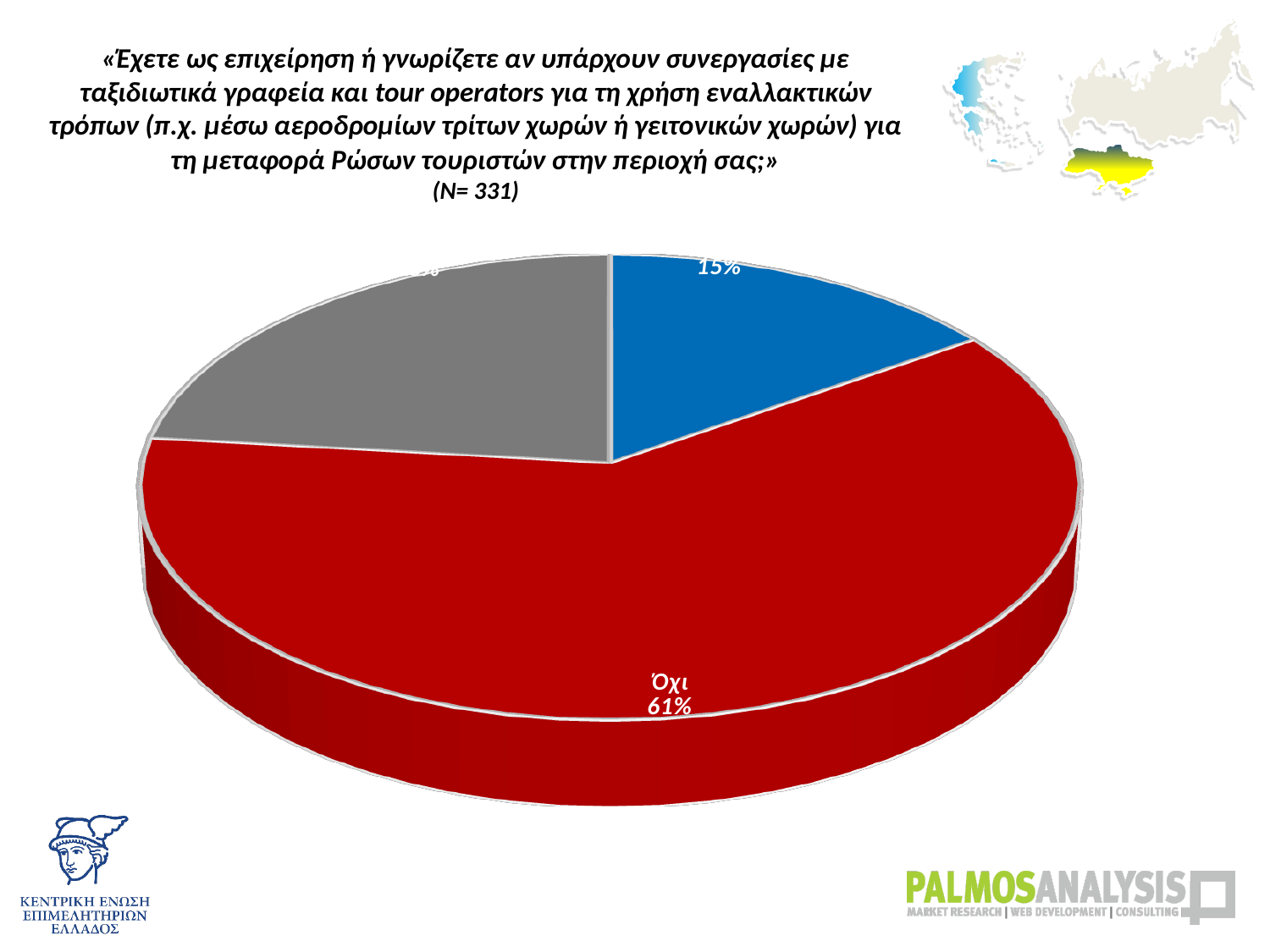
Does the "Όχι" slice account for more or less than half of the pie? More What percentage of respondents answered "Όχι"? 61% What colour is the "Όχι" slice of the pie chart? Red Which is larger, the red slice or the blue slice? The red slice How many slices does the pie chart have? 3 Which slice of the pie chart is the largest? Όχι (the red slice) What kind of chart is shown on the slide? Pie chart What percentage is shown on the blue slice of the pie chart? 15% Which slice of the pie chart is the smallest? The blue slice (15%) What is the sample size (N) stated under the chart title? 331 By how many percentage points does the "Όχι" slice exceed the blue slice? 46 percentage points